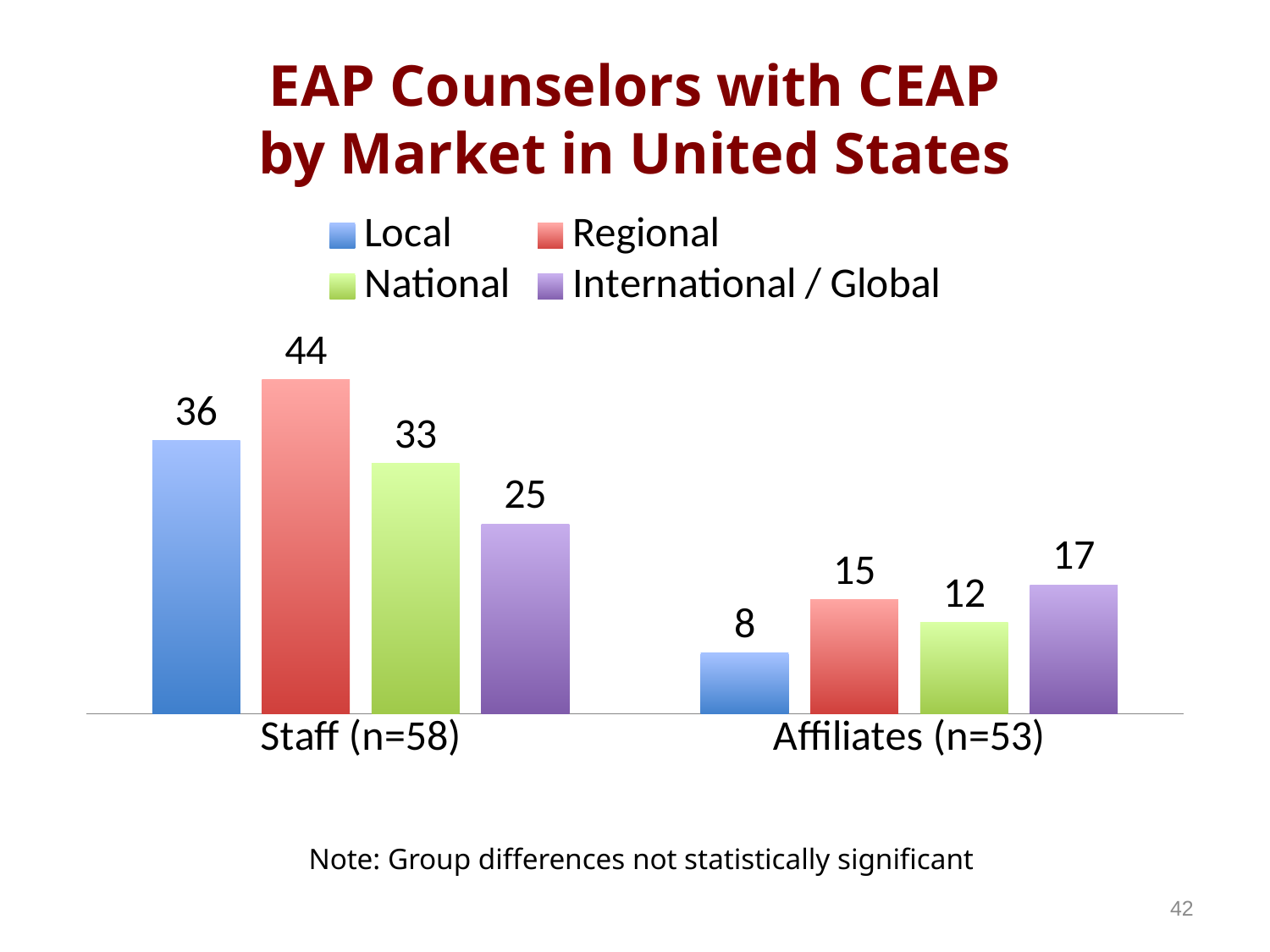
What is the value for Regional in the Staff (n=58) category? 44 How many series does the legend list? 4 What is the value for International / Global in the Staff (n=58) category? 25 What colour represents the International / Global series? Purple What kind of chart is shown on the slide? Bar chart What is the difference between the Regional and National values for Affiliates (n=53)? 3 What is the value for Local in the Affiliates (n=53) category? 8 Which series has the lowest value in the Affiliates (n=53) category? Local Which series has the highest value in the Staff (n=58) category? Regional What is the difference between the Local values for Staff (n=58) and Affiliates (n=53)? 28 How many categories are shown on the x axis? 2 Which is larger: National for Staff (n=58) or International / Global for Staff (n=58)? National for Staff (n=58)